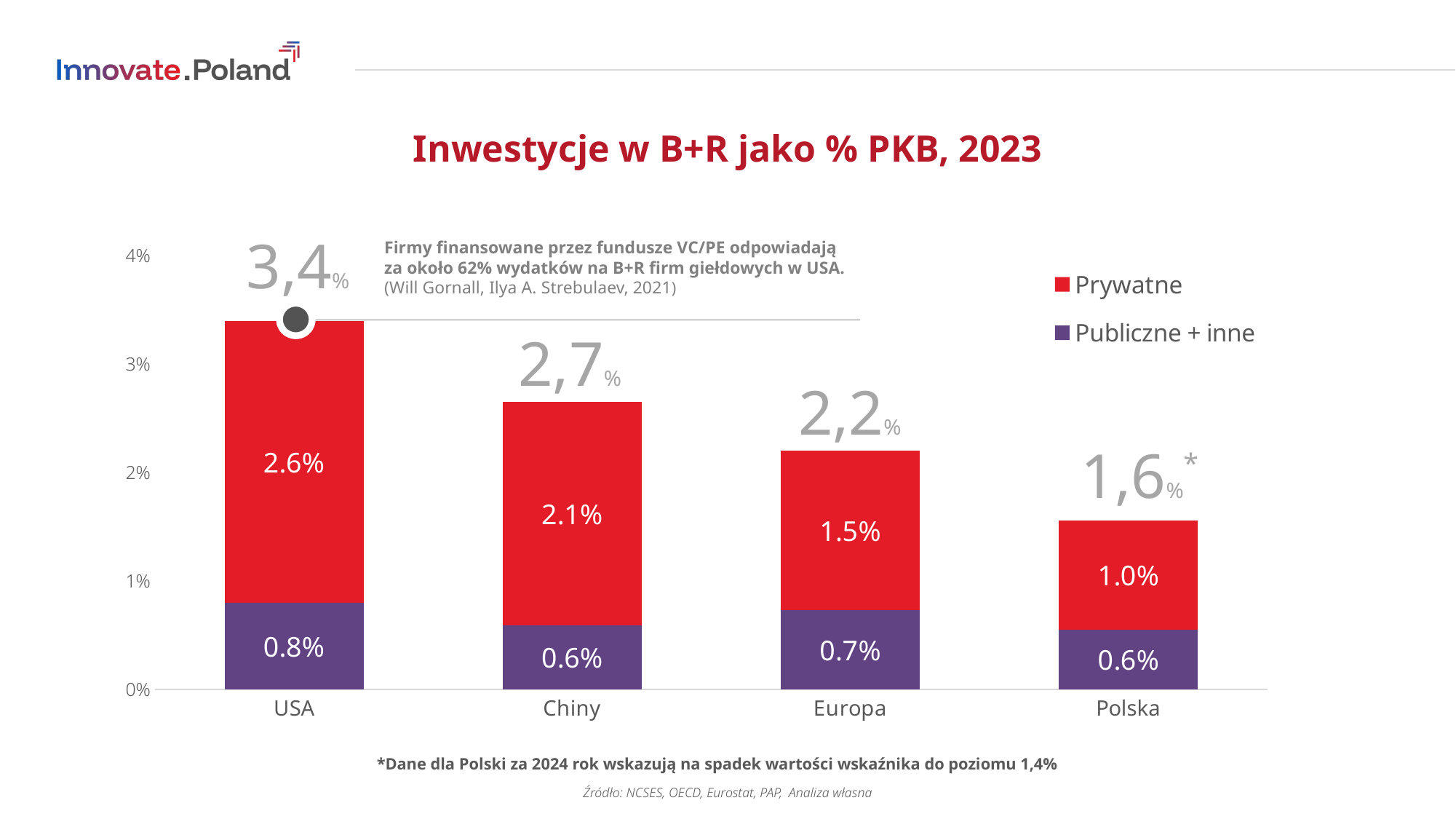
How many categories are shown on the x axis? 4 What is the Prywatne value for USA? 2.6% Which is larger, the Publiczne + inne value for USA or for Chiny? USA Which category has the highest total R&D investment as % of GDP? USA What is the title of the chart? Inwestycje w B+R jako % PKB, 2023 What is the total value of the stacked bar for Chiny? 2,7% What is the Publiczne + inne value for Europa? 0.7% How many series does the legend list? 2 What kind of chart is shown on the slide? Stacked bar chart Which category has the lowest Prywatne value? Polska What is the difference between the Prywatne values for USA and Chiny? 0.5% What is the Prywatne value for Polska? 1.0%